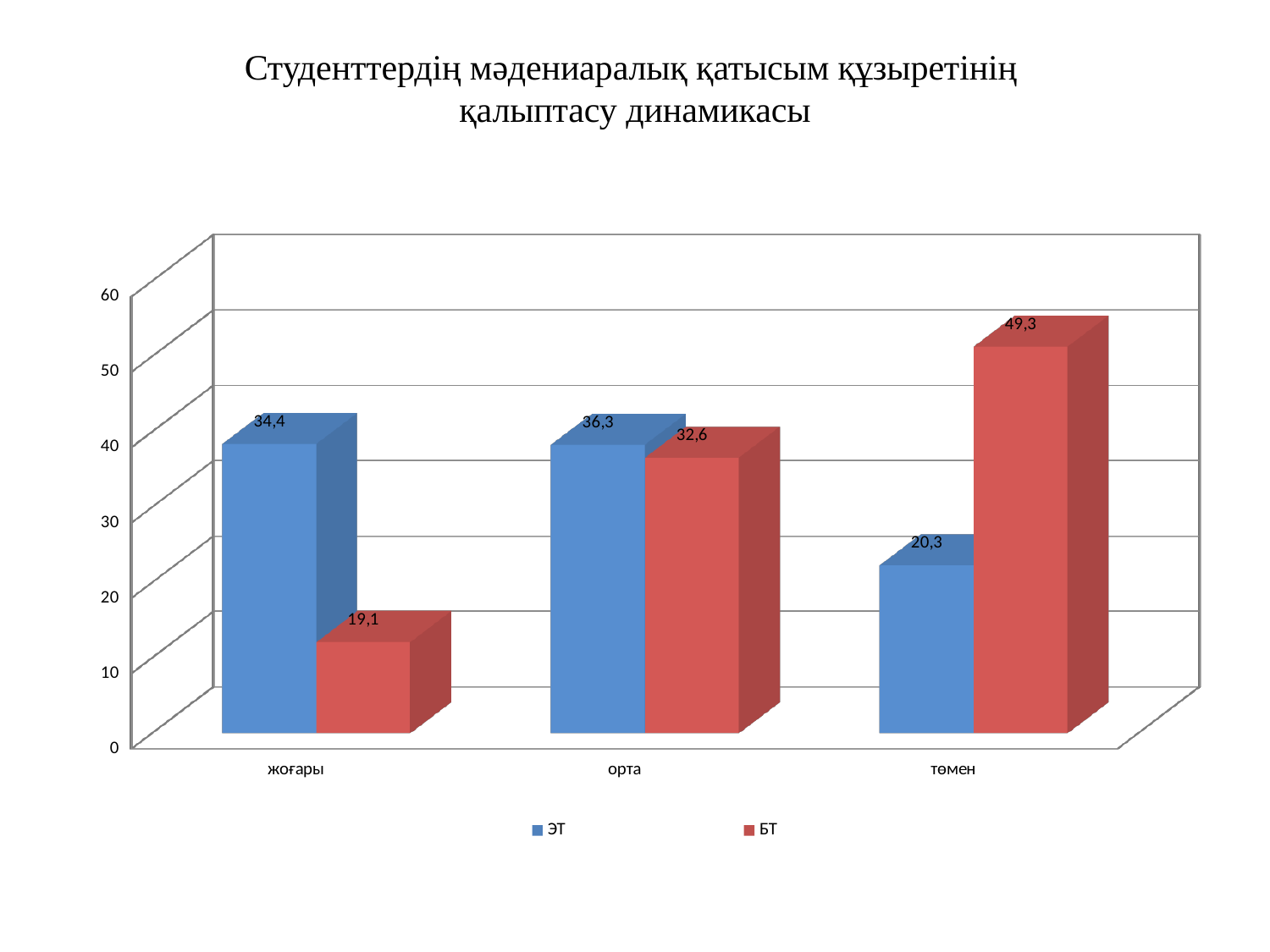
Which category has the highest value for the БТ series? төмен What is the value for ЭТ in the төмен category? 20,3 What is the value for ЭТ in the жоғары category? 34,4 Which category has the lowest value for the ЭТ series? төмен What is the difference between the ЭТ and БТ values in the жоғары category? 15,3 What is the difference between the БТ and ЭТ values in the төмен category? 29 What is the value for БТ in the төмен category? 49,3 What kind of chart is shown on the slide? bar chart How many categories are shown on the x axis? 3 What is the value for БТ in the орта category? 32,6 In the орта category, which series has the larger value, ЭТ or БТ? ЭТ How many series does the legend list? 2